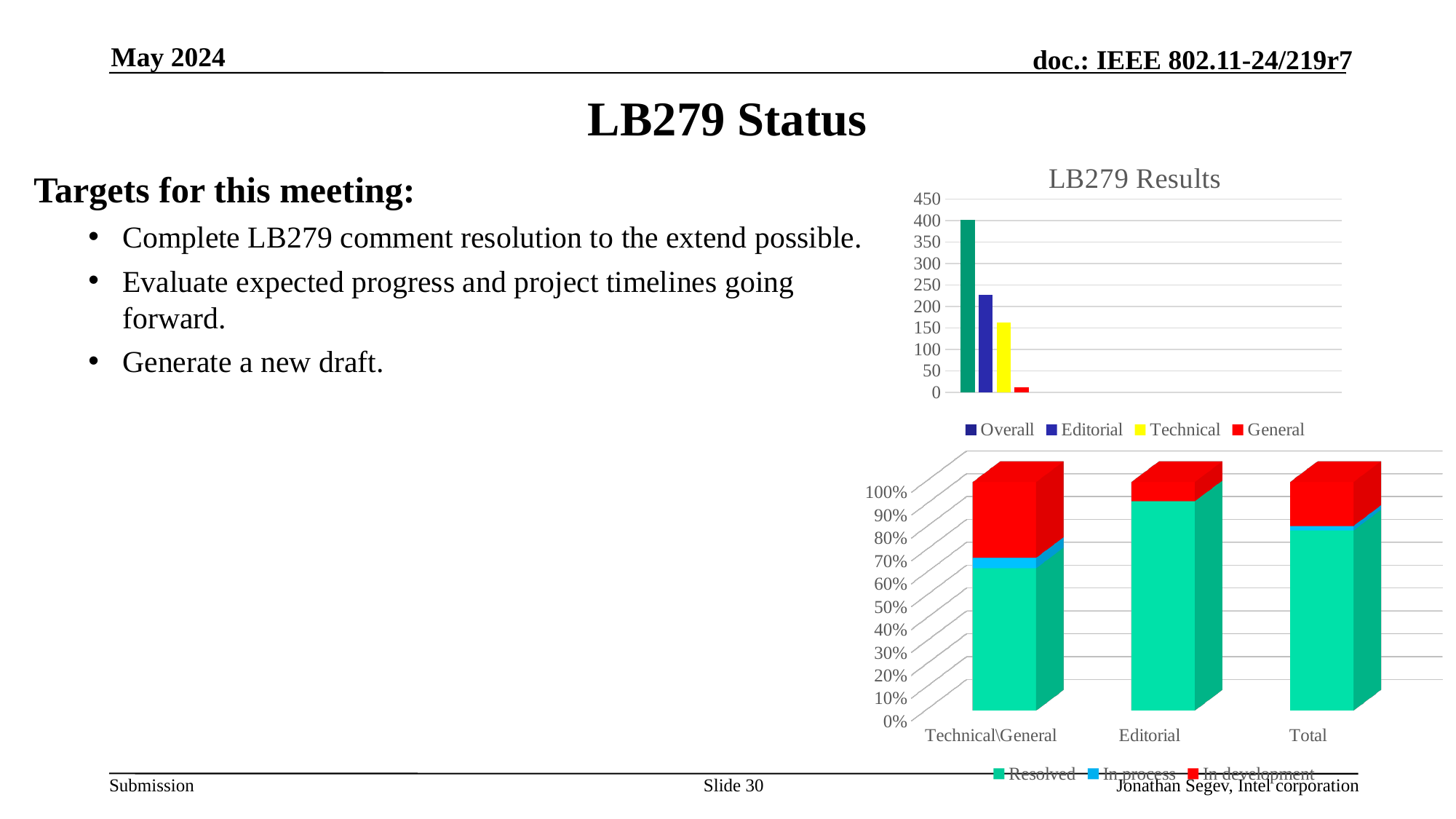
In the LB279 Results chart, is the value for Overall greater or less than 350? greater In the LB279 Results chart, is the value for Editorial greater or less than 300? less In the LB279 Results chart, which is larger, Editorial or Technical? Editorial In the lower stacked percentage chart, how many series does the legend list? 3 In the lower stacked percentage chart, is the Resolved share for Technical\General greater or less than 50%? greater What kind of chart is the LB279 Results chart? bar chart In the lower stacked percentage chart, how many categories are shown on the x axis? 3 In the LB279 Results chart, which series has the lowest value? General In the LB279 Results chart, which series has the highest value? Overall How many series does the legend of the LB279 Results chart list? 4